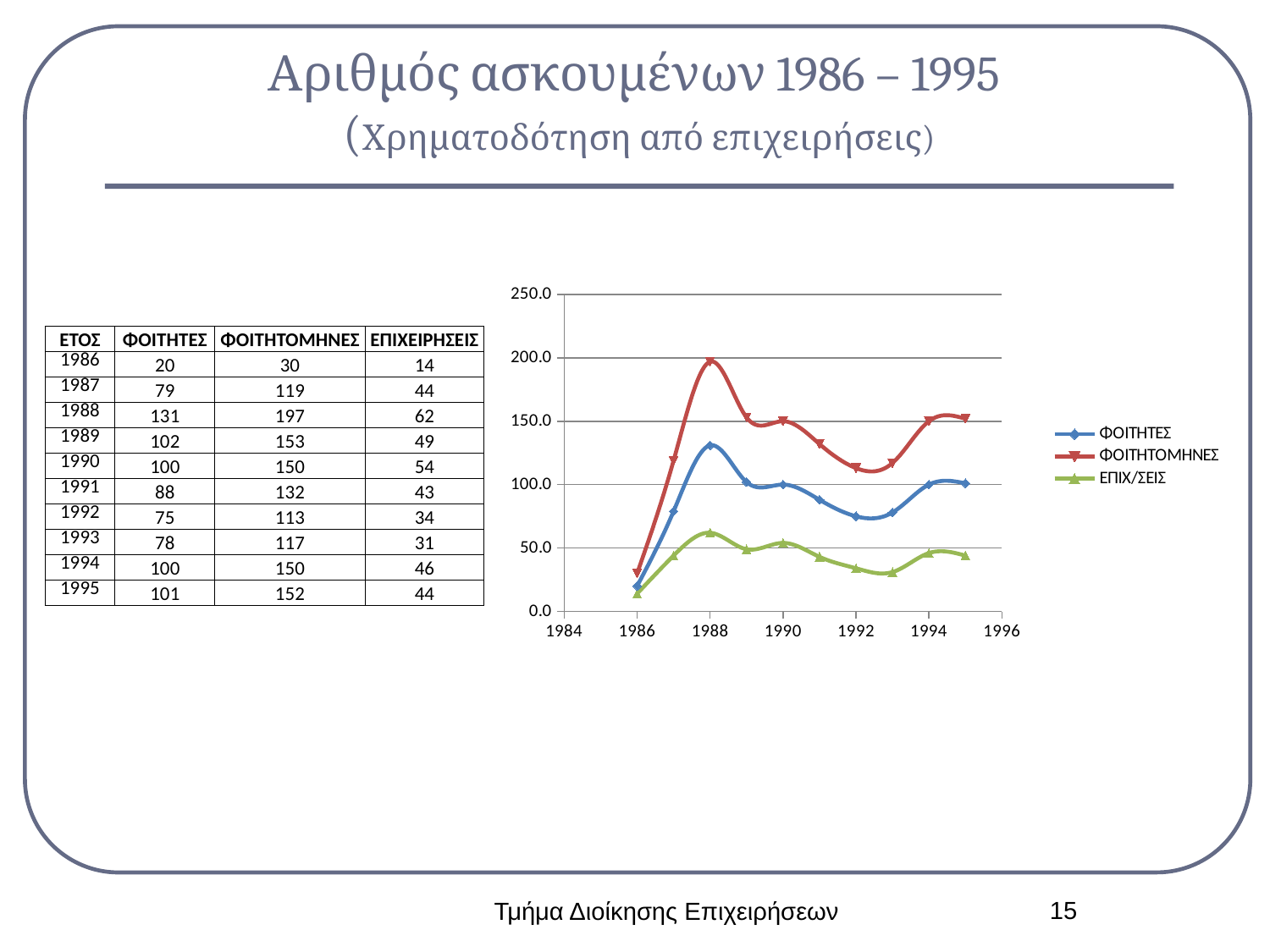
Is the value for ΕΠΙΧ/ΣΕΙΣ in 1986 greater or less than 50? less How many series does the chart legend list? 3 Does the ΦΟΙΤΗΤΕΣ series rise or fall between 1986 and 1988? rise Which series has the larger value in 1990, ΦΟΙΤΗΤΕΣ or ΕΠΙΧ/ΣΕΙΣ? ΦΟΙΤΗΤΕΣ By how much did the ΦΟΙΤΗΤΕΣ value increase from 1986 to 1988? 111 In which year does the ΦΟΙΤΗΤΟΜΗΝΕΣ series reach its highest value? 1988 What colour is the ΦΟΙΤΗΤΟΜΗΝΕΣ line in the chart? red What kind of chart is shown on the slide? line chart In which year is the ΕΠΙΧ/ΣΕΙΣ series at its lowest? 1986 Is the value for ΦΟΙΤΗΤΟΜΗΝΕΣ in 1988 greater or less than 150? greater What is the value of ΦΟΙΤΗΤΟΜΗΝΕΣ in 1988? 197 How many data points does each series in the chart have? 10